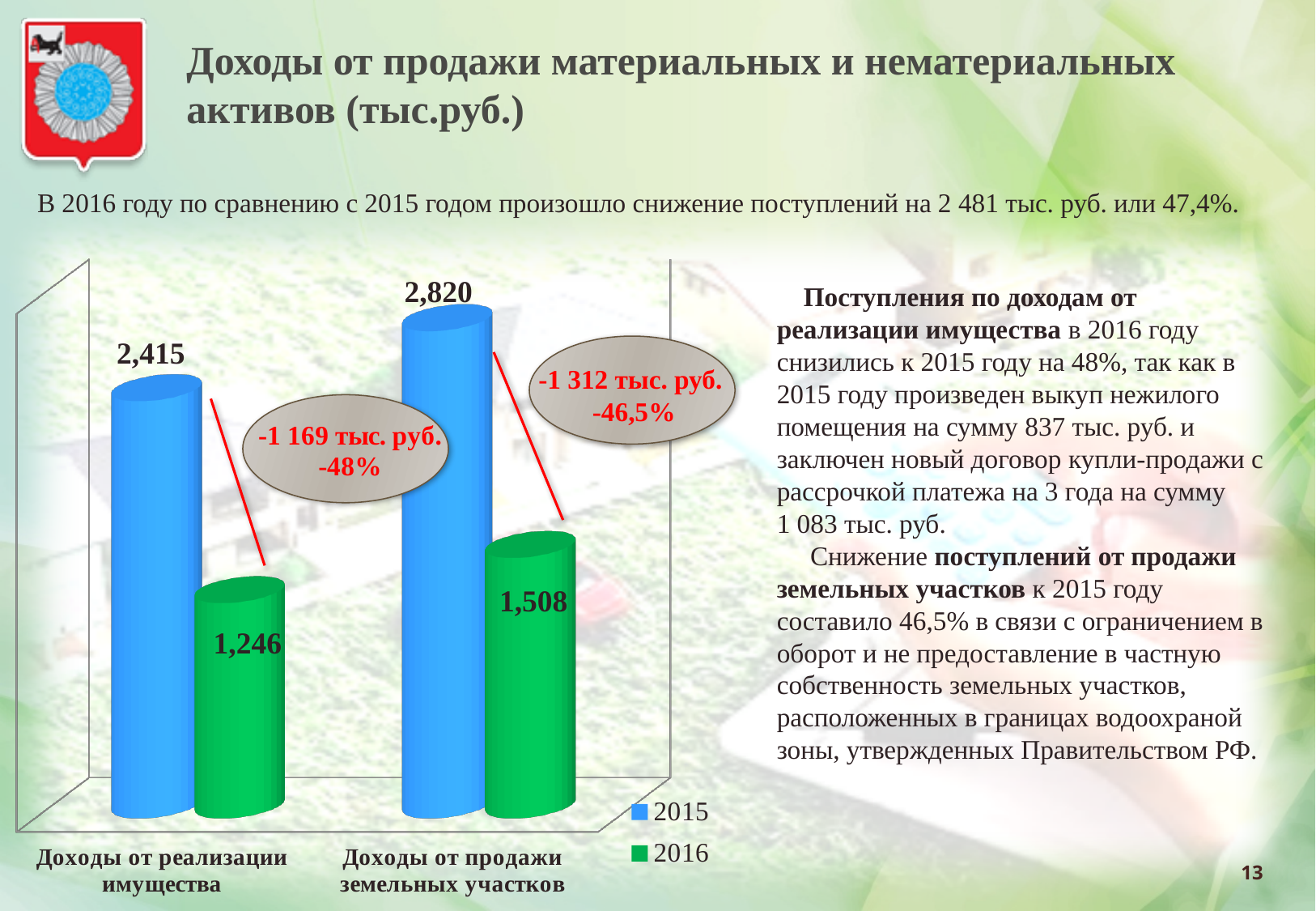
How many series does the chart legend list? 2 What kind of chart is shown on the slide? Bar chart What is the difference between the 2015 and 2016 values for Доходы от продажи земельных участков? 1,312 What is the difference between the 2015 and 2016 values for Доходы от реализации имущества? 1,169 Which bar in the chart has the lowest value? Доходы от реализации имущества, 2016 What is the 2016 value for Доходы от продажи земельных участков? 1,508 Which bar in the chart has the highest value? Доходы от продажи земельных участков, 2015 What is the 2015 value for Доходы от продажи земельных участков? 2,820 How many categories are shown on the x axis of the chart? 2 Which is larger: the 2016 value for Доходы от реализации имущества or the 2016 value for Доходы от продажи земельных участков? Доходы от продажи земельных участков What is the 2015 value for Доходы от реализации имущества? 2,415 What is the 2016 value for Доходы от реализации имущества? 1,246